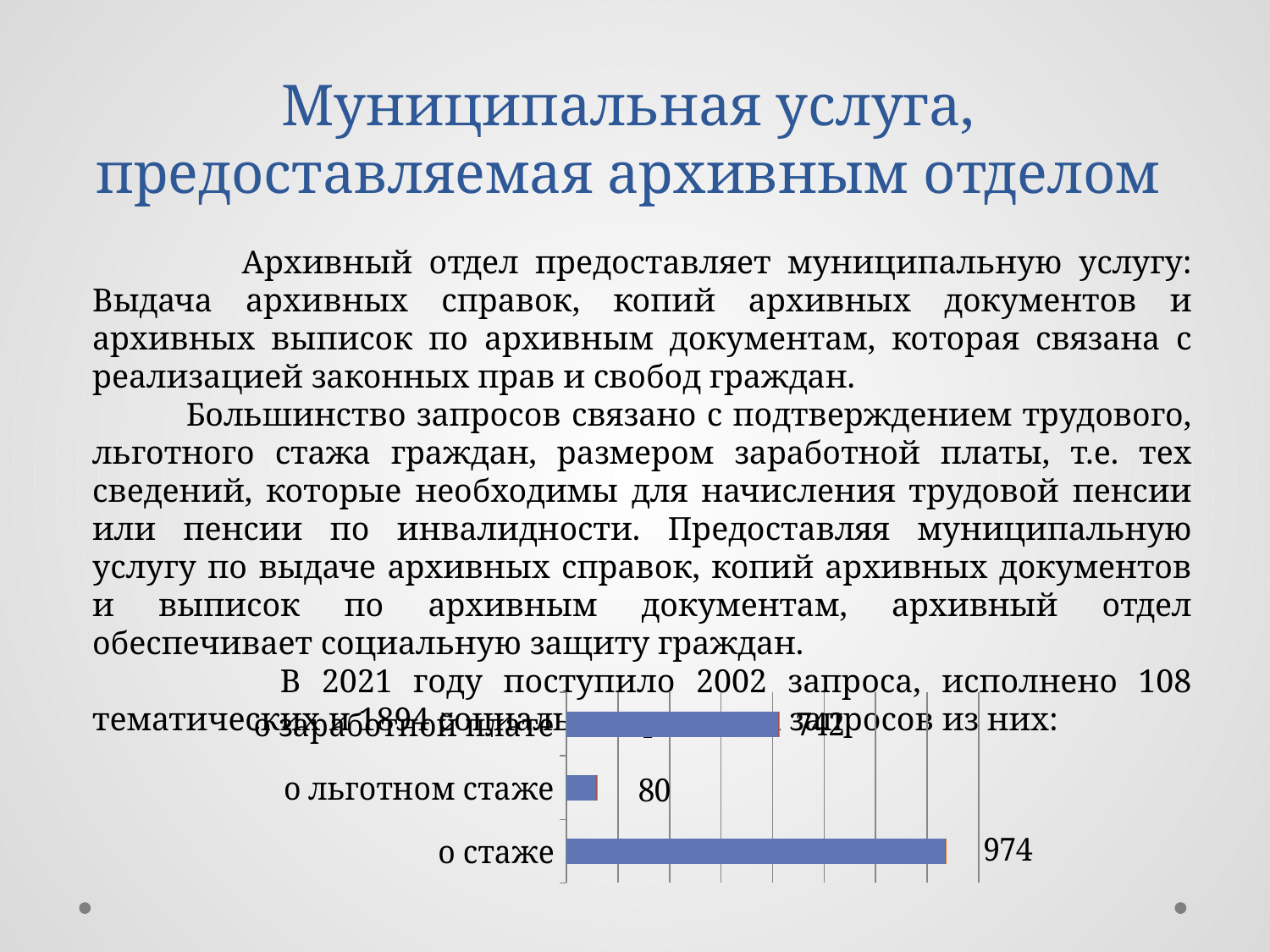
Which is larger in the bar chart: the value for "о заработной плате" or the value for "о льготном стаже"? о заработной плате How many categories does the bar chart show? 3 Which category has the highest value in the bar chart? о стаже Which is larger in the bar chart: the value for "о стаже" or the value for "о заработной плате"? о стаже Are the bars in the chart oriented horizontally or vertically? horizontally What is the value for "о стаже" in the bar chart? 974 What kind of chart is shown at the bottom of the slide? bar chart What is the difference between the values for "о стаже" and "о льготном стаже"? 894 Which category has the lowest value in the bar chart? о льготном стаже What is the value for "о льготном стаже" in the bar chart? 80 What colour are the bars in the chart? blue Which is larger in the bar chart: the value for "о стаже" or the value for "о льготном стаже"? о стаже